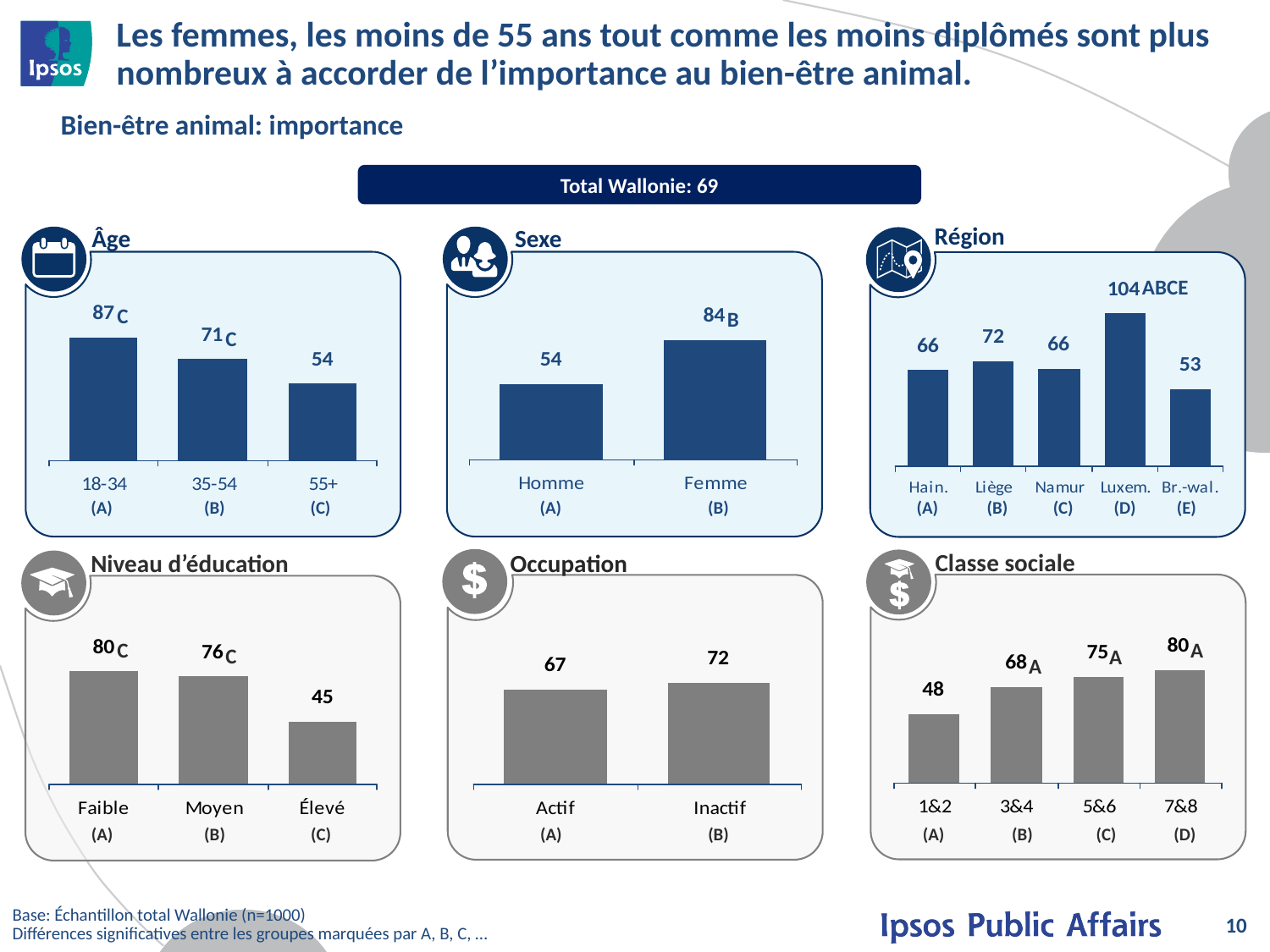
What kind of chart is the Sexe chart? bar chart What is the Total Wallonie value shown above the charts? 69 In the Niveau d'éducation chart, what is the difference between the values for Faible and Élevé? 35 In the Âge chart, what is the difference between the values for 18-34 and 55+? 33 In the Région chart, which region has the lowest value? Br.-wal. In the Sexe chart, what is the value for Femme? 84 In the Région chart, which region has the highest value? Luxem. In the Région chart, what is the value for Liège? 72 In the Occupation chart, which is larger, the value for Actif or for Inactif? Inactif In the Classe sociale chart, how many categories are shown? 4 In the Âge chart, what is the value for the 18-34 group? 87 In the Classe sociale chart, do the values rise or fall from 1&2 to 7&8? rise